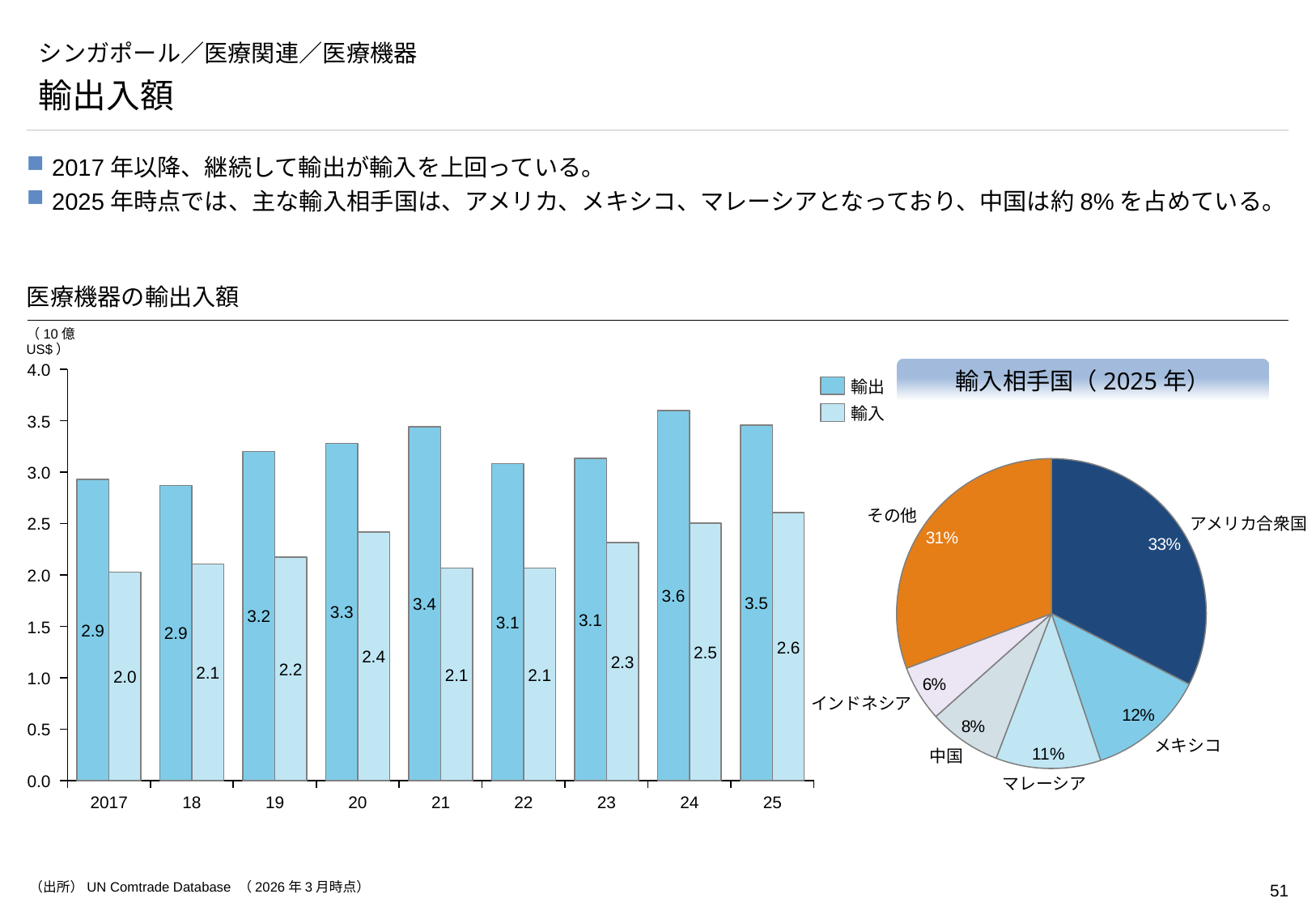
In the bar chart 医療機器の輸出入額, what is the 輸出 value for 2024? 3.6 In the pie chart 輸入相手国（2025年）, what share does メキシコ have? 12% In the bar chart 医療機器の輸出入額, does the 輸入 value rise or fall from 2022 to 2025? rise In the bar chart 医療機器の輸出入額, what is the 輸入 value for 2020? 2.4 In the bar chart 医療機器の輸出入額, which is larger in 2021, 輸出 or 輸入? 輸出 In the bar chart 医療機器の輸出入額, how many series does the legend list? 2 In the pie chart 輸入相手国（2025年）, which country has the largest share? アメリカ合衆国 In the bar chart 医療機器の輸出入額, how many years are shown on the x axis? 9 In the bar chart 医療機器の輸出入額, which year has the highest 輸出 value? 24 In the bar chart 医療機器の輸出入額, what is the difference between 輸出 and 輸入 in 2024? 1.1 In the bar chart 医療機器の輸出入額, which year has the lowest 輸入 value? 2017 What kind of chart is 輸入相手国（2025年）? pie chart